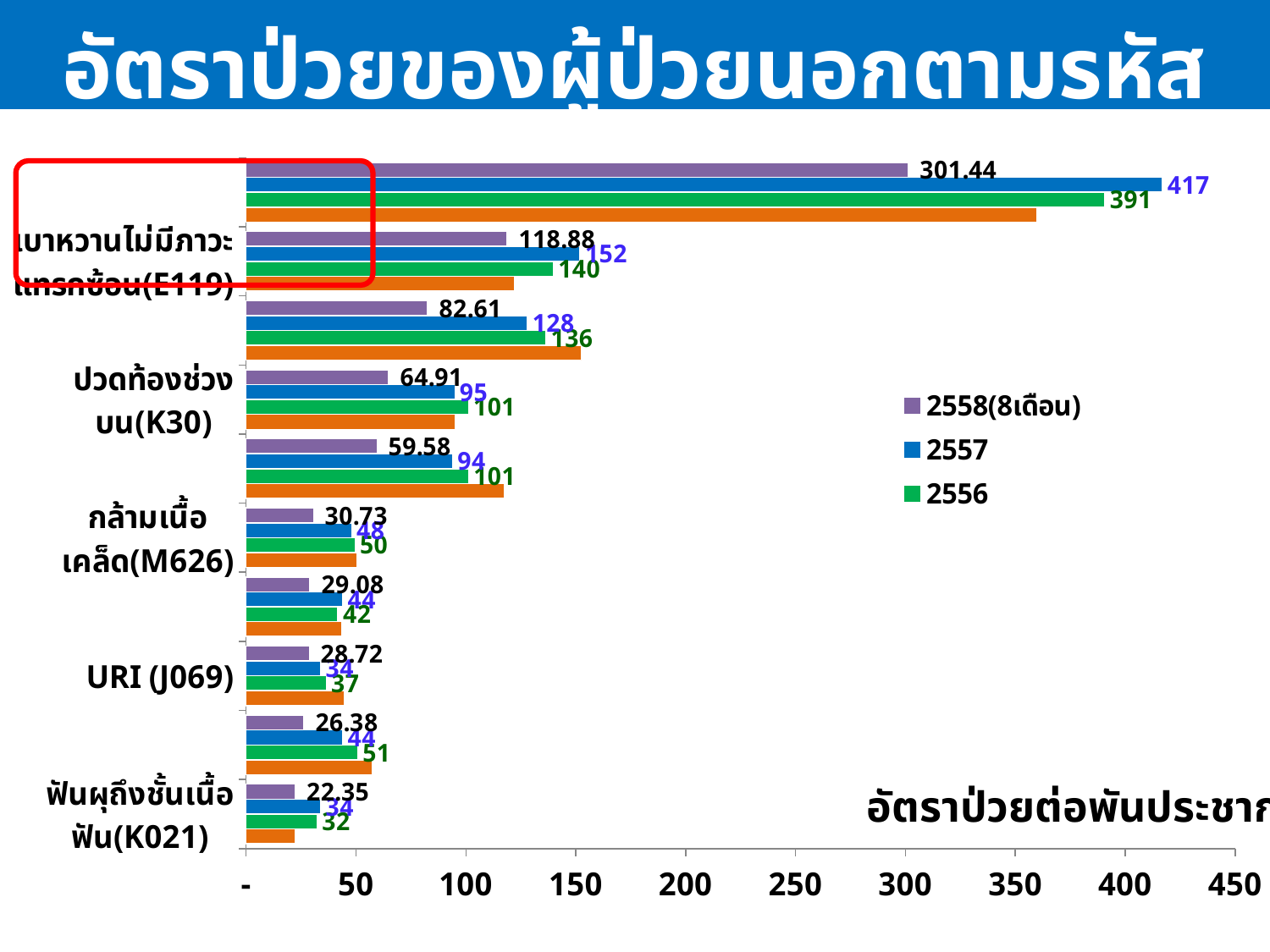
How many series does the legend list? 3 What is the difference between the 2557 and 2558(8เดือน) values for เบาหวานไม่มีภาวะแทรกซ้อน(E119)? 33.12 Among the series listed in the legend, which has the highest value for ปวดท้องช่วงบน(K30)? 2556 What is the value for 2556 for ฟันผุถึงชั้นเนื้อฟัน(K021)? 32 What is the value for 2558(8เดือน) for ปวดท้องช่วงบน(K30)? 64.91 What kind of chart is shown on the slide? bar chart What is the value for 2557 for เบาหวานไม่มีภาวะแทรกซ้อน(E119)? 152 What is the value for 2556 for กล้ามเนื้อเคล็ด(M626)? 50 What is the value for 2558(8เดือน) for URI (J069)? 28.72 Among the series listed in the legend, which has the lowest value for URI (J069)? 2558(8เดือน) What is the difference between the 2556 and 2557 values for ปวดท้องช่วงบน(K30)? 6 For ฟันผุถึงชั้นเนื้อฟัน(K021), which is larger: the 2557 value or the 2556 value? 2557